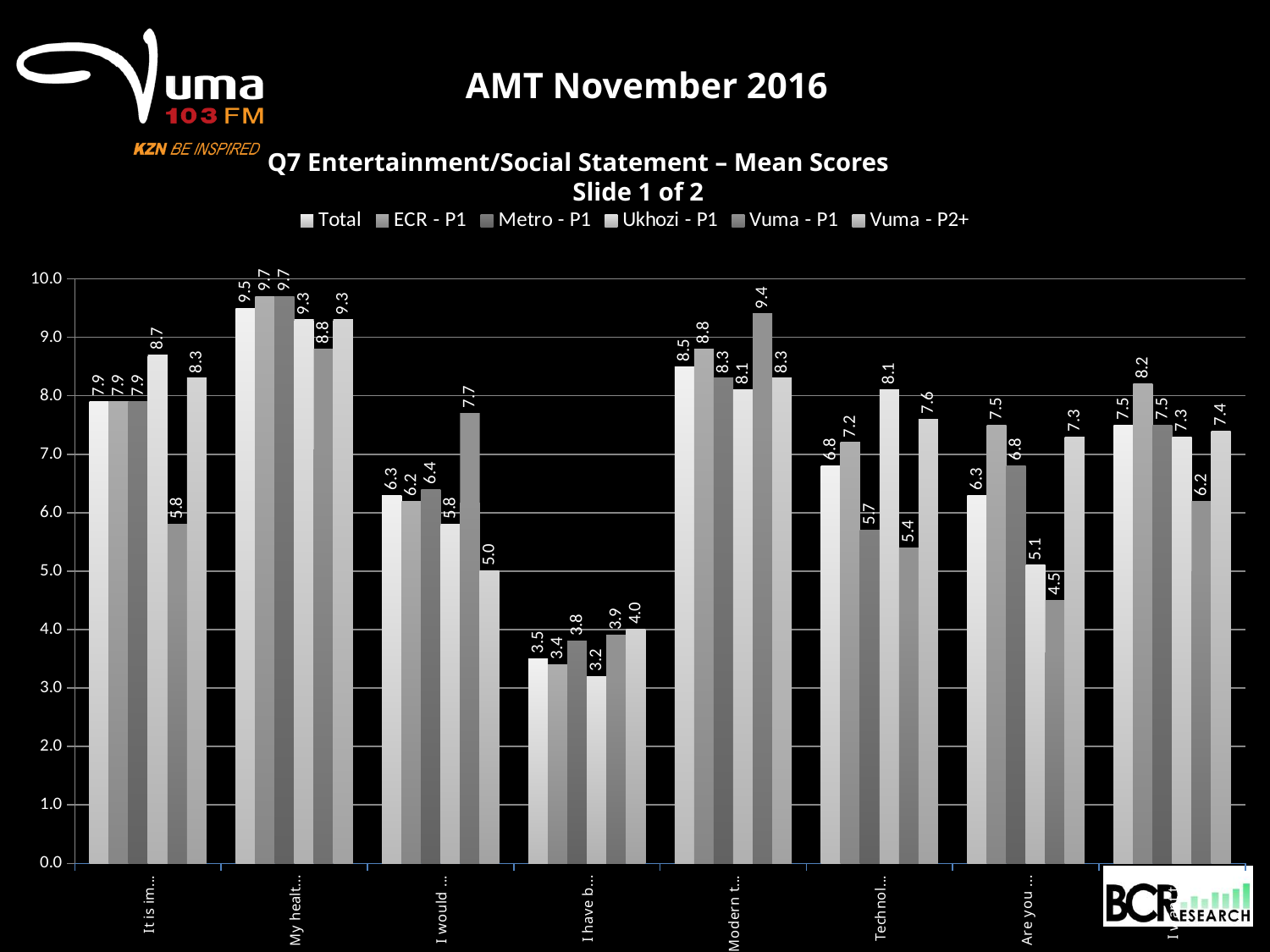
How many groups of bars (categories) are plotted along the x axis? 8 In the fourth group of bars ("I have b..."), which series has the highest value? Vuma - P2+ What is the title of the chart? Q7 Entertainment/Social Statement – Mean Scores Slide 1 of 2 In the first group of bars ("It is im..."), what is the difference between the Ukhozi - P1 value and the Vuma - P1 value? 2.9 How many series does the legend list? 6 Is the Total value in the fourth group of bars ("I have b...") greater or less than 4.0? less What is the Ukhozi - P1 value in the sixth group of bars ("Technol...")? 8.1 In the seventh group of bars ("Are you ..."), which series has the lowest value? Vuma - P1 In the fifth group of bars ("Modern t..."), which is larger: the Vuma - P1 value or the ECR - P1 value? Vuma - P1 What is the Total value in the second group of bars ("My healt...")? 9.5 What is the Vuma - P1 value in the first group of bars ("It is im...")? 5.8 What kind of chart is shown on the slide? bar chart